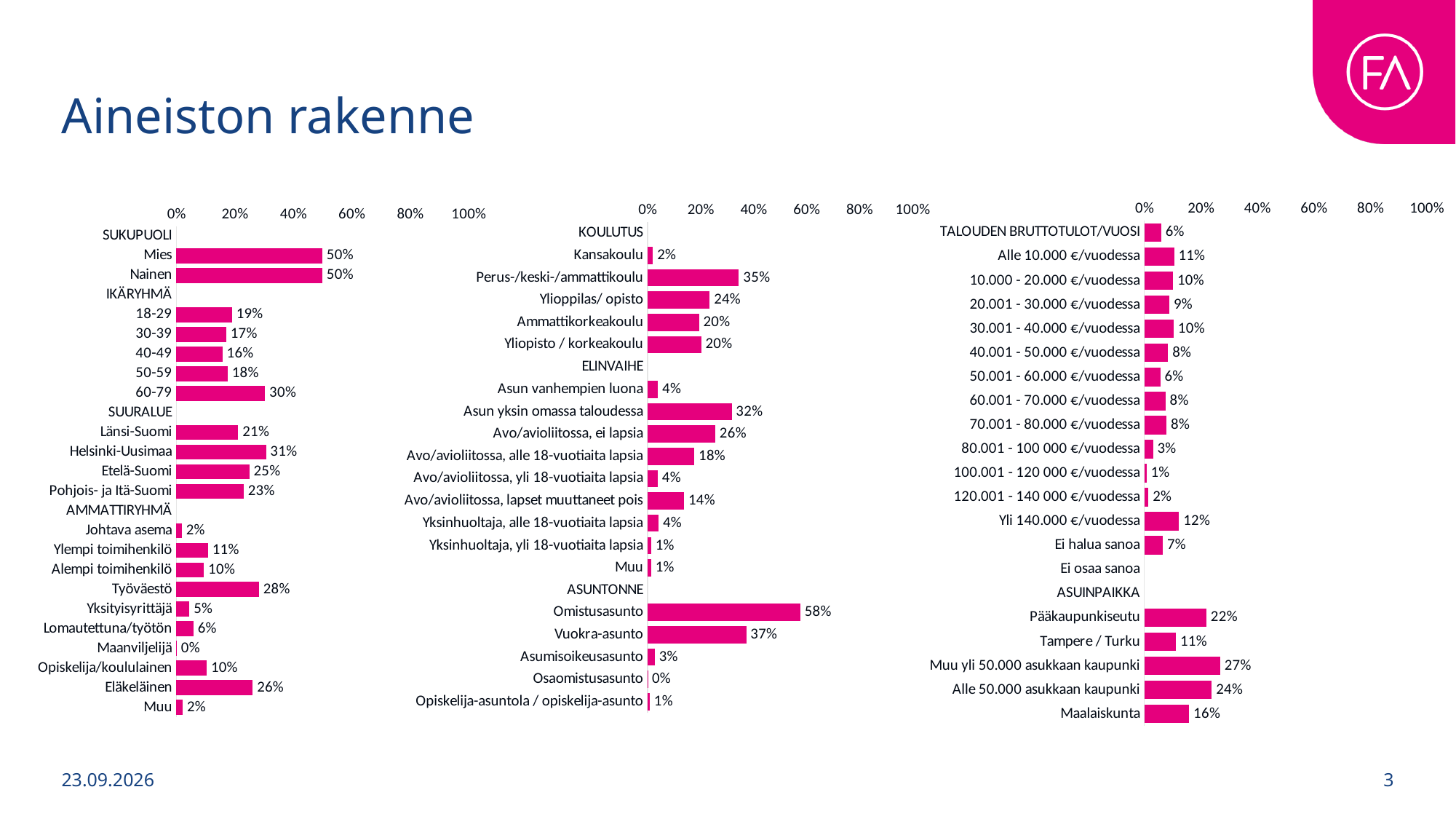
In the right chart, which ASUINPAIKKA category has the lowest value? Tampere / Turku In the middle chart, which ELINVAIHE category has the highest value? Asun yksin omassa taloudessa In the middle chart, what is the value for Omistusasunto? 58% In the left chart, what is the value for Helsinki-Uusimaa? 31% In the left chart, which age group (IKÄRYHMÄ) has the highest value? 60-79 In the right chart, what is the difference between Pääkaupunkiseutu and Tampere / Turku? 11% What type of chart is the left chart? bar chart In the right chart, what is the value for Yli 140.000 €/vuodessa? 12% In the left chart, what is the difference between Työväestö and Eläkeläinen? 2% What is the title of the slide? Aineiston rakenne In the middle chart, which is larger, Perus-/keski-/ammattikoulu or Ylioppilas/ opisto? Perus-/keski-/ammattikoulu In the middle chart, what is the difference between Omistusasunto and Vuokra-asunto? 21%